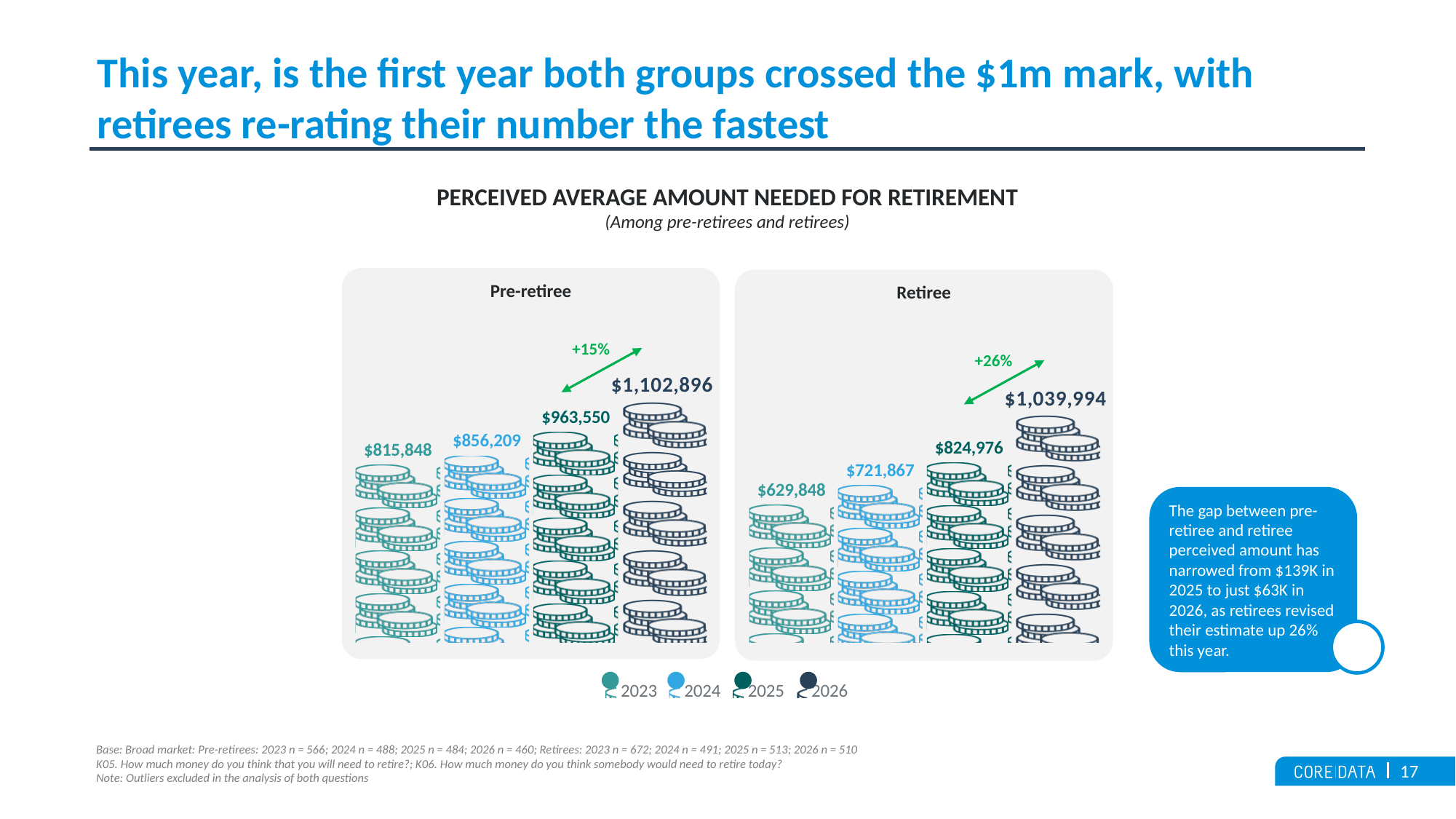
What is the perceived average amount needed for retirement among retirees in 2025? $824,976 What is the perceived average amount needed for retirement among pre-retirees in 2026? $1,102,896 In the Pre-retiree panel, which year has the highest perceived amount needed for retirement? 2026 How many years does the legend list? 4 What is the perceived average amount needed for retirement among retirees in 2023? $629,848 In the Retiree panel, which year has the lowest perceived amount needed for retirement? 2023 Which is larger, the pre-retiree amount in 2023 or the retiree amount in 2024? Pre-retiree amount in 2023 Do the perceived amounts rise or fall from 2023 to 2026 in the Retiree panel? Rise By how much did the retiree perceived amount increase from 2025 to 2026? $215,018 What is the difference between the pre-retiree and retiree perceived amounts in 2026? $62,902 What is the perceived average amount needed for retirement among pre-retirees in 2024? $856,209 What percentage increase is shown for retirees between 2025 and 2026? +26%